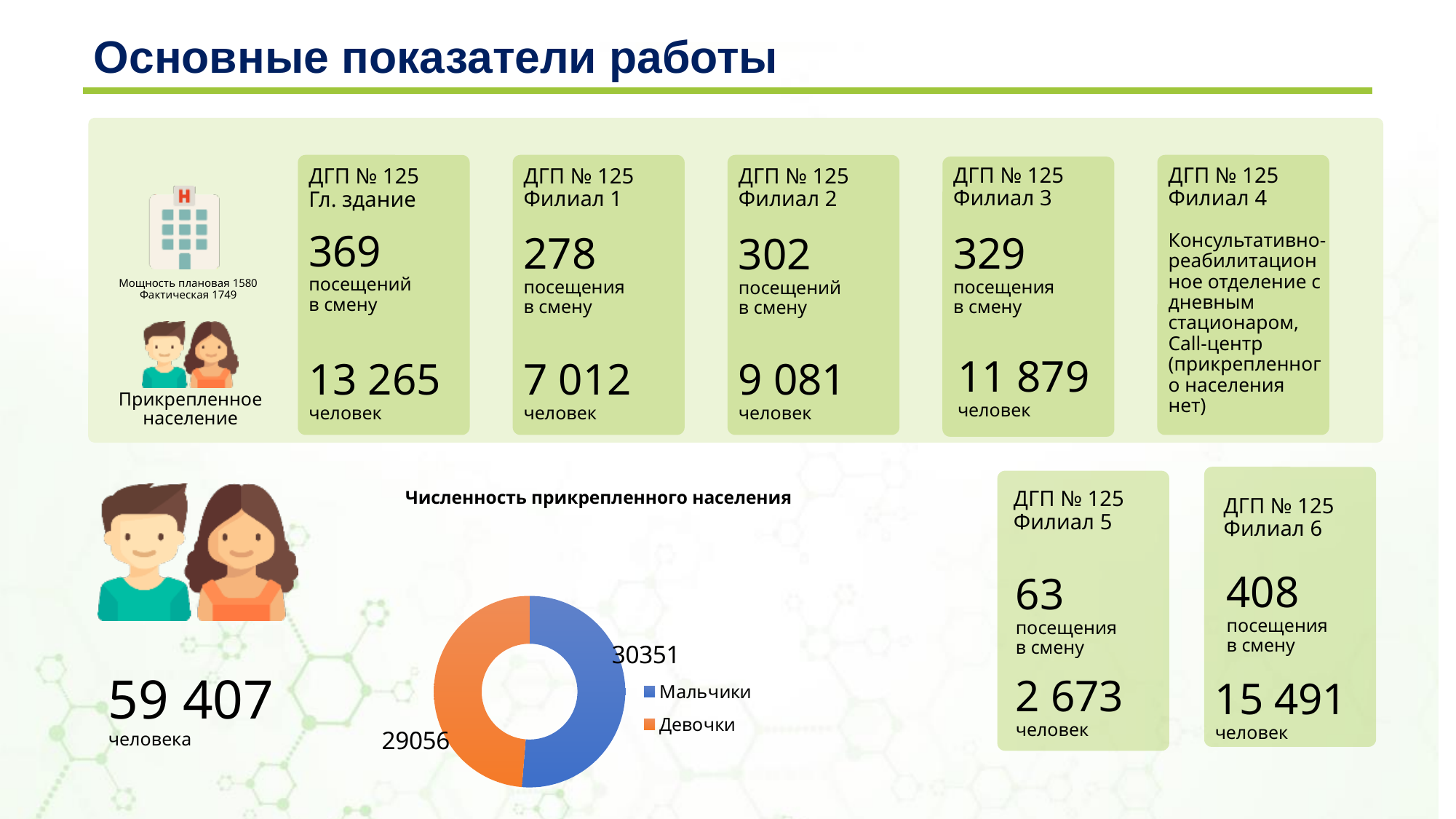
What colour represents Девочки in the chart? Orange What is the title of the chart? Численность прикрепленного населения Which category has the smallest value in the chart? Девочки How many entries does the chart legend list? 2 What kind of chart is shown on the slide? Doughnut (pie) chart What is the difference between the values for Мальчики and Девочки? 1295 Which is larger, the value for Мальчики or the value for Девочки? Мальчики Which category has the largest value in the chart? Мальчики What is the value for Мальчики in the chart? 30351 What is the value for Девочки in the chart? 29056 What is the total of the two values shown in the chart? 59407 How many categories are shown in the chart? 2